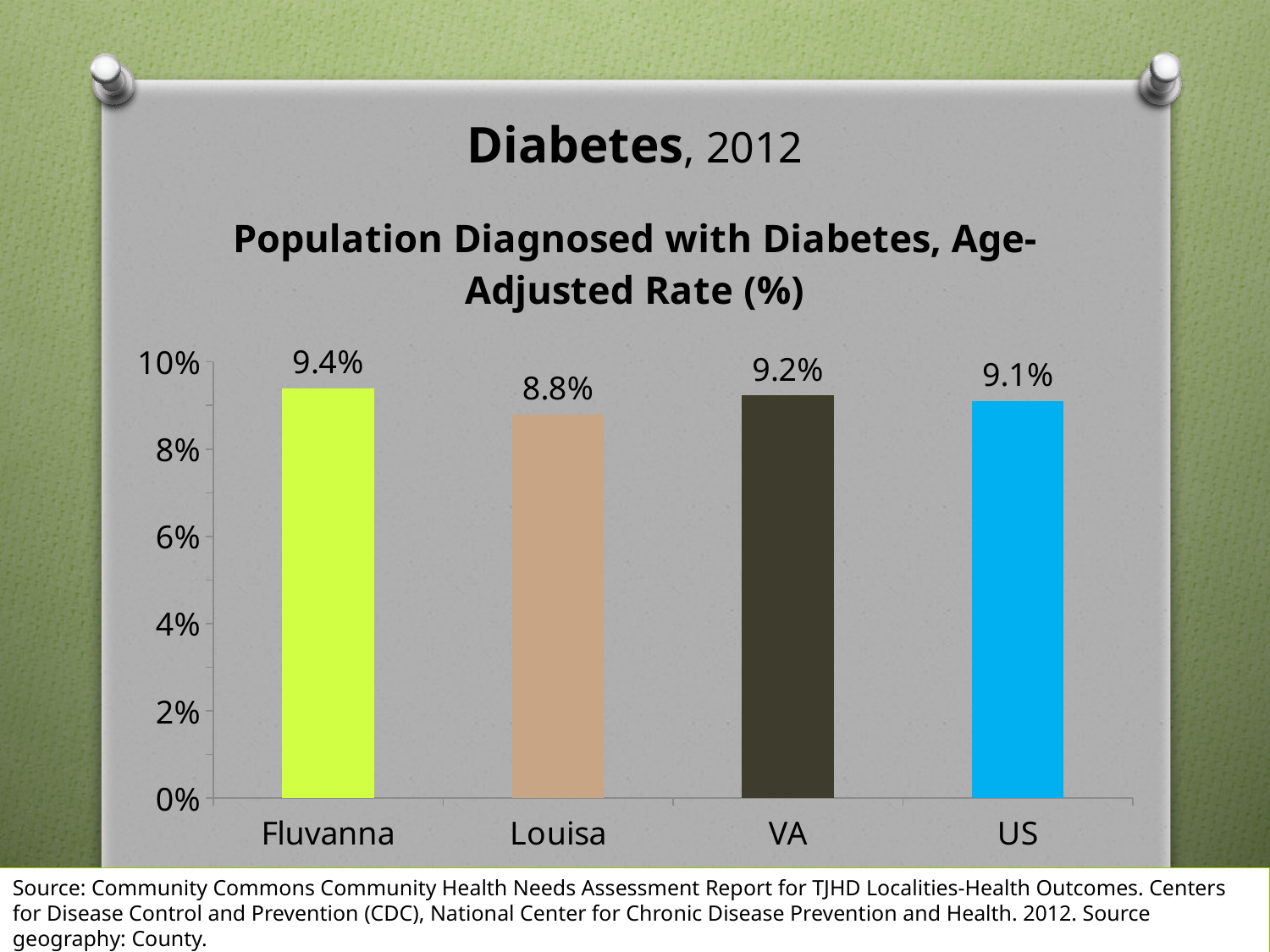
What is the title of the chart? Population Diagnosed with Diabetes, Age-Adjusted Rate (%) What is the age-adjusted diabetes rate for Louisa? 8.8% What kind of chart is shown on the slide? Bar chart What is the age-adjusted diabetes rate for Fluvanna? 9.4% Which locality has the highest age-adjusted diabetes rate? Fluvanna Which locality has the lowest age-adjusted diabetes rate? Louisa How many categories are shown on the x axis of the chart? 4 Which has a higher diabetes rate, Fluvanna or VA? Fluvanna What is the difference between the diabetes rates for Fluvanna and Louisa? 0.6% What is the age-adjusted diabetes rate for US? 9.1% What is the age-adjusted diabetes rate for VA? 9.2% What is the difference between the diabetes rates for VA and US? 0.1%